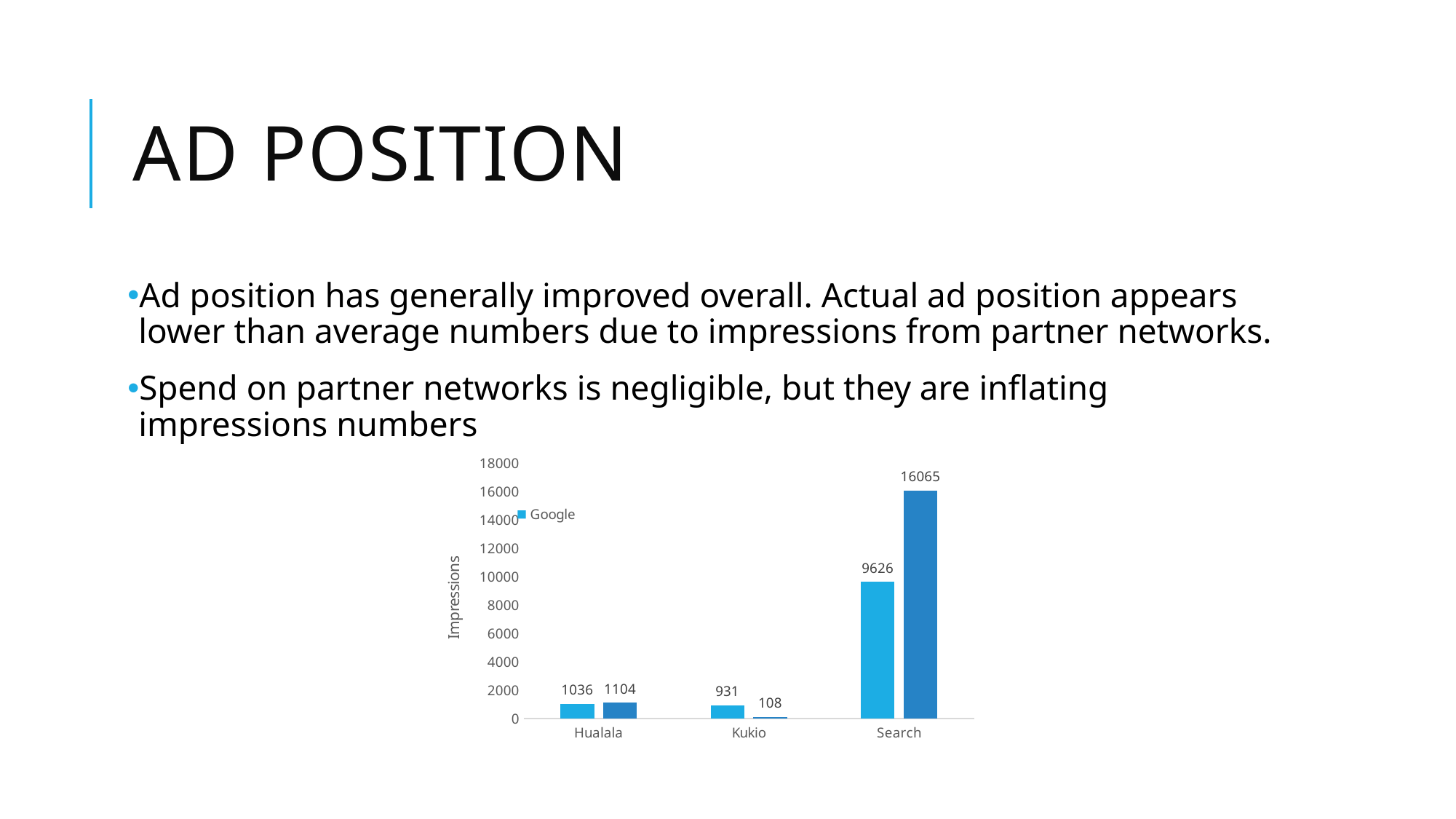
What is the highest value labelled on the chart? 16065 Which has more Google impressions, Hualala or Kukio? Hualala What is the Google impressions value for Search? 9626 Which category has the highest Google impressions? Search What is the difference between the Google impressions for Search and for Hualala? 8590 What is the Google impressions value for Hualala? 1036 What series name is shown in the chart legend? Google What kind of chart is shown on the slide? bar chart How many categories are shown on the x axis? 3 What is the label of the vertical axis? Impressions What is the Google impressions value for Kukio? 931 Which category has the lowest Google impressions? Kukio